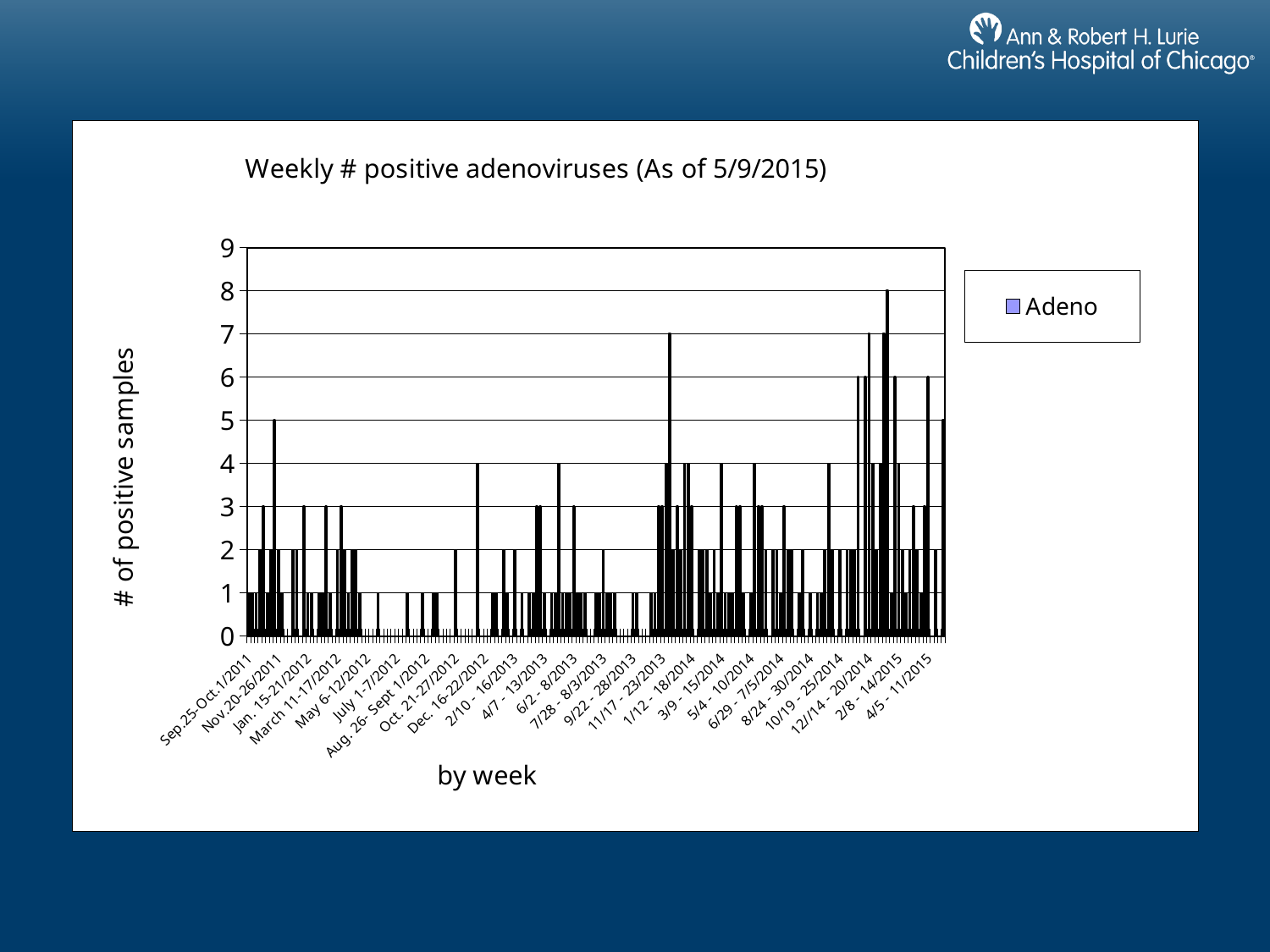
Is the tallest bar in the chart greater or less than 5? greater What is the title of the chart? Weekly # positive adenoviruses (As of 5/9/2015) What is the name of the series shown in the legend? Adeno How many series does the legend list? 1 What is the maximum value shown on the y axis? 9 Are the weekly counts generally higher in the 2014-2015 portion of the chart or in the mid-2012 portion? 2014-2015 Is the highest bar in the 2012 portion of the chart (between May 6-12/2012 and Dec. 16-22/2012) greater or less than 5? less What is the highest weekly number of positive samples reached by any bar in the chart? 8 What kind of chart is shown on the slide? bar chart